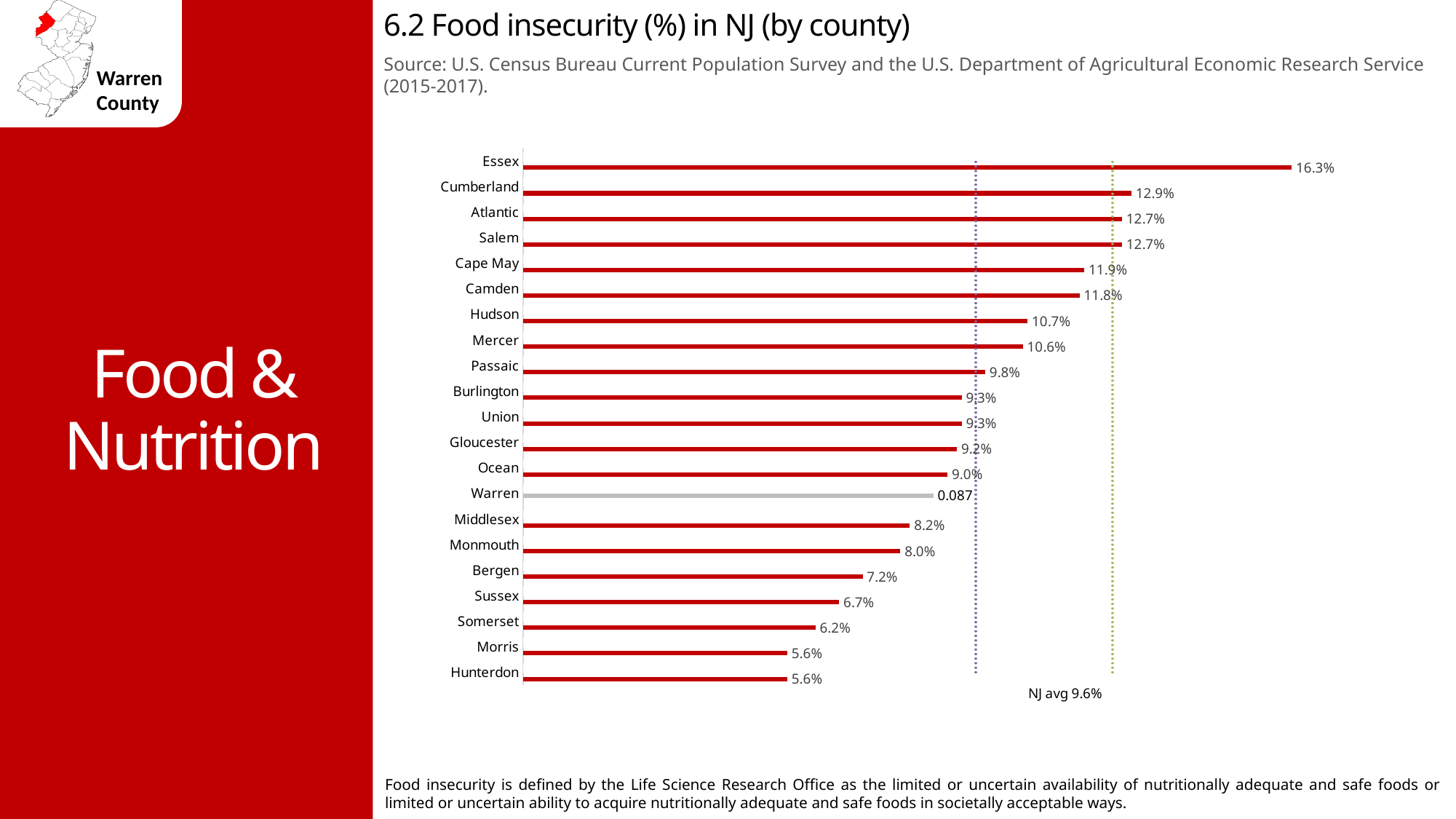
Which has a higher food insecurity value, Sussex or Somerset? Sussex What is the food insecurity value shown for Cumberland? 12.9% What is the food insecurity value shown for Bergen? 7.2% What is the difference between the values for Essex and Cumberland? 3.4% What is the difference between the values for Hudson and Mercer? 0.1% What is the food insecurity value shown for Essex? 16.3% Which county has the highest food insecurity value on the chart? Essex Which has a higher food insecurity value, Cape May or Passaic? Cape May How many counties are plotted on the chart? 21 What value is printed next to the Warren bar? 0.087 What NJ average value is noted on the chart? 9.6% What kind of chart is shown on the slide? Bar chart